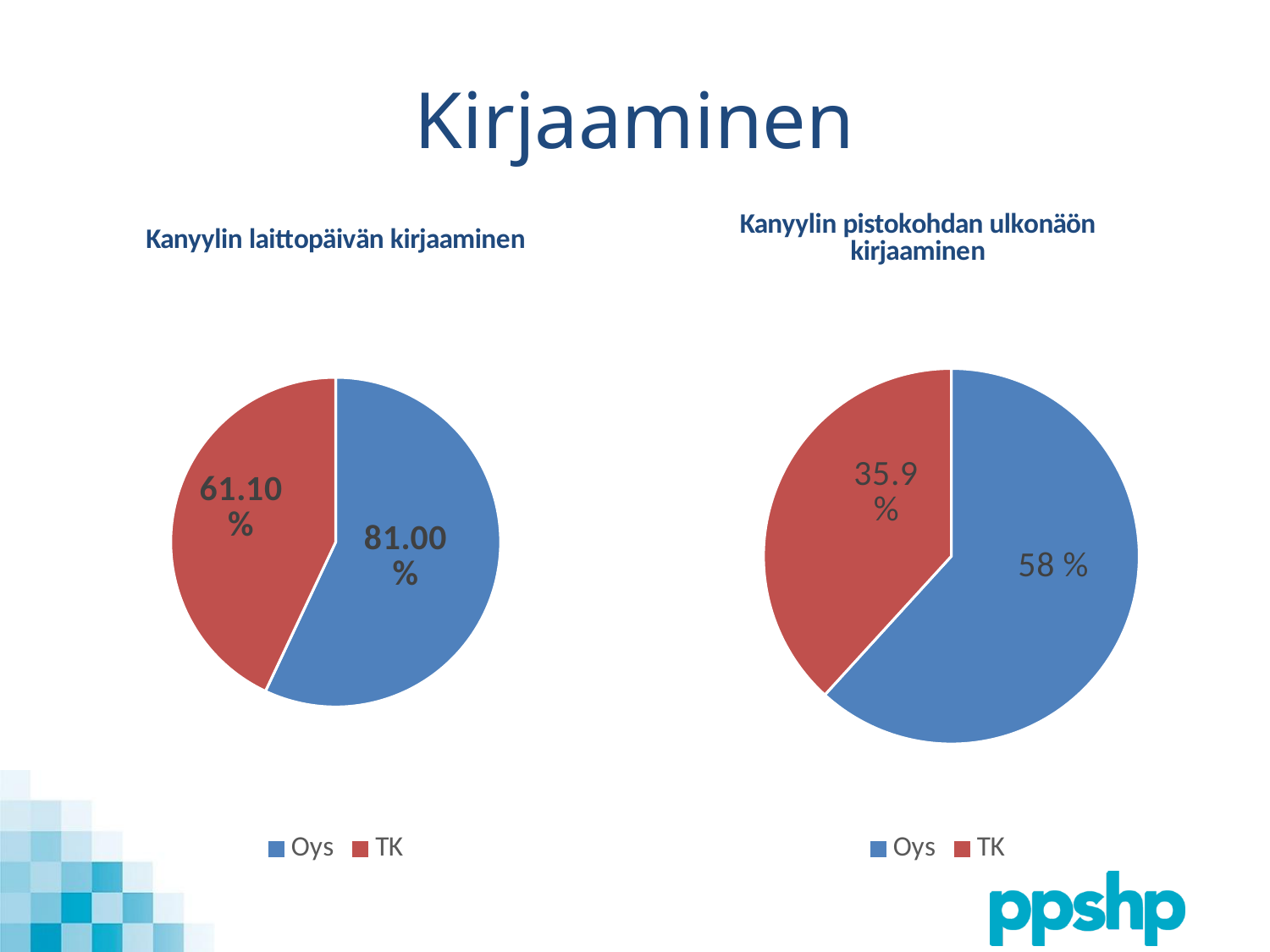
How many categories does the legend of the right chart list? 2 In the right chart, which colour represents TK? Red What is the title of the chart on the right side of the slide? Kanyylin pistokohdan ulkonäön kirjaaminen In the left chart, which category has the larger value, Oys or TK? Oys In the chart titled "Kanyylin pistokohdan ulkonäön kirjaaminen", what value is shown for Oys? 58 % In the right chart, which category has the smallest value? TK What type of chart is used on the left side of the slide? Pie chart In the chart titled "Kanyylin laittopäivän kirjaaminen", what value is shown for Oys? 81.00 % In the chart titled "Kanyylin pistokohdan ulkonäön kirjaaminen", what value is shown for TK? 35.9 % In the chart titled "Kanyylin laittopäivän kirjaaminen", what is the difference between the Oys and TK values? 19.90 percentage points In the chart titled "Kanyylin laittopäivän kirjaaminen", what value is shown for TK? 61.10 % In the chart titled "Kanyylin pistokohdan ulkonäön kirjaaminen", what is the difference between the Oys and TK values? 22.1 percentage points